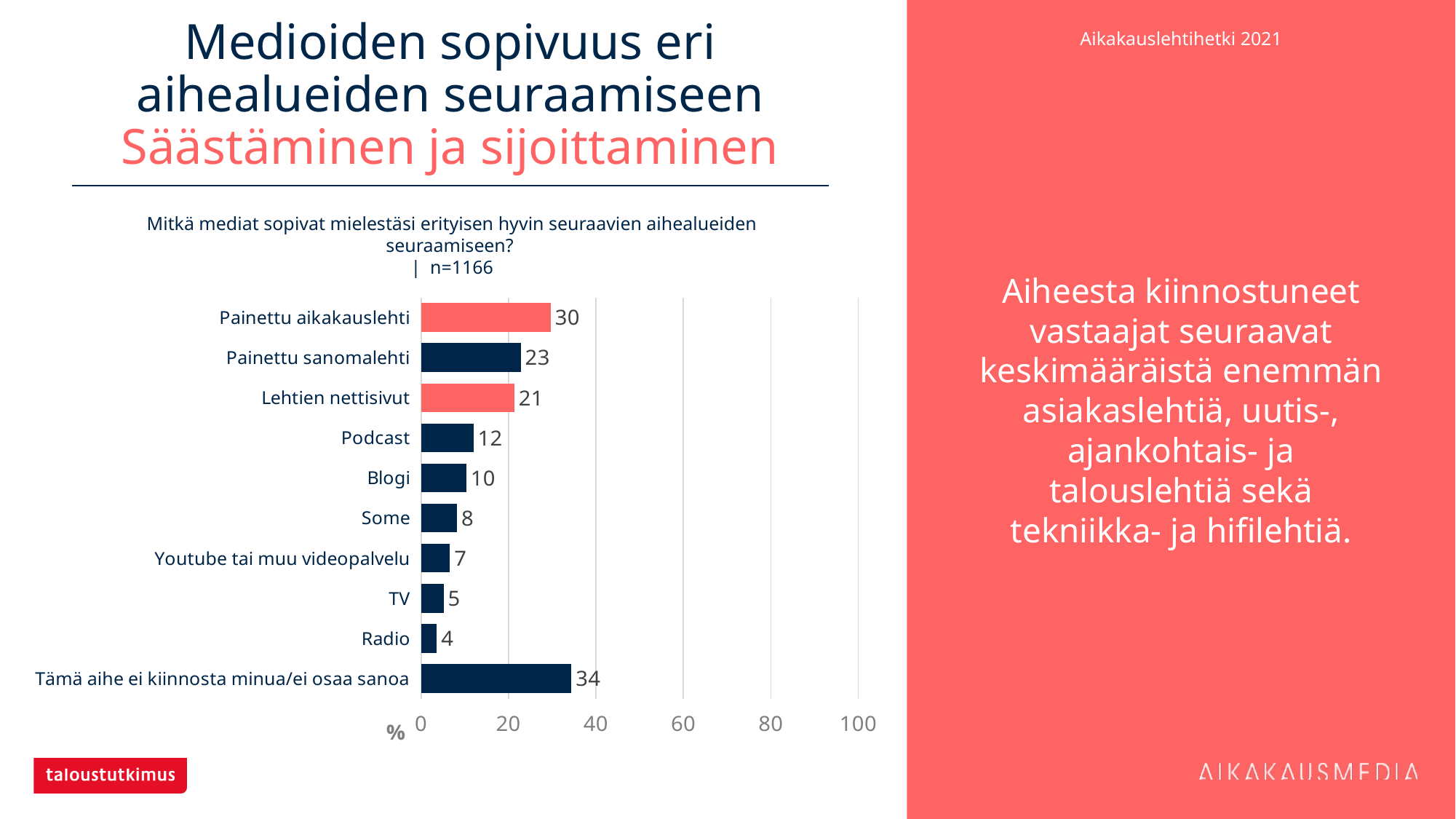
What is the sample size (n) stated above the chart? n=1166 What is the value for Radio? 4 How many categories are shown in the chart? 10 What is the value for Painettu aikakauslehti? 30 Is the value for Lehtien nettisivut greater or less than 40? less Which is larger, the value for Blogi or the value for Some? Blogi What is the value for Podcast? 12 Which two categories are shown with red bars instead of dark blue? Painettu aikakauslehti and Lehtien nettisivut Which category has the lowest value? Radio What is the difference between the values for Painettu aikakauslehti and Painettu sanomalehti? 7 What kind of chart is shown on the slide? bar chart Which category has the highest value? Tämä aihe ei kiinnosta minua/ei osaa sanoa